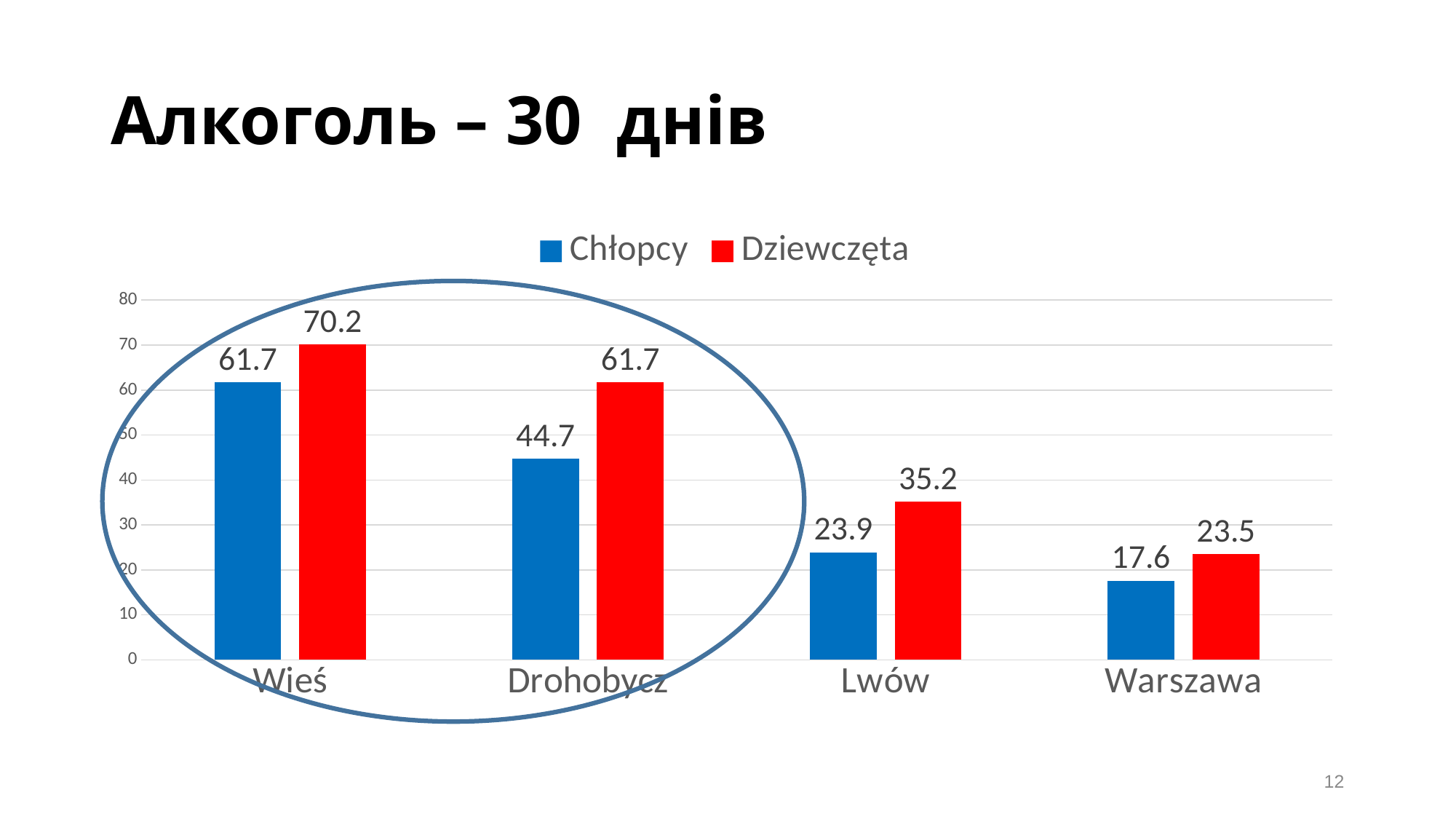
What is the value for Dziewczęta in Warszawa? 23.5 What is the value for Chłopcy in Lwów? 23.9 What kind of chart is shown on the slide? Bar chart Which category has the lowest value for Chłopcy? Warszawa What is the difference between the Dziewczęta and Chłopcy values in Drohobycz? 17 Which is larger in Lwów: the Chłopcy value or the Dziewczęta value? Dziewczęta What is the value for Chłopcy in Wieś? 61.7 What is the value for Dziewczęta in Drohobycz? 61.7 How many categories are shown on the x axis? 4 Which category has the highest value for Dziewczęta? Wieś How many series does the legend list? 2 Which colour represents the Chłopcy series? Blue